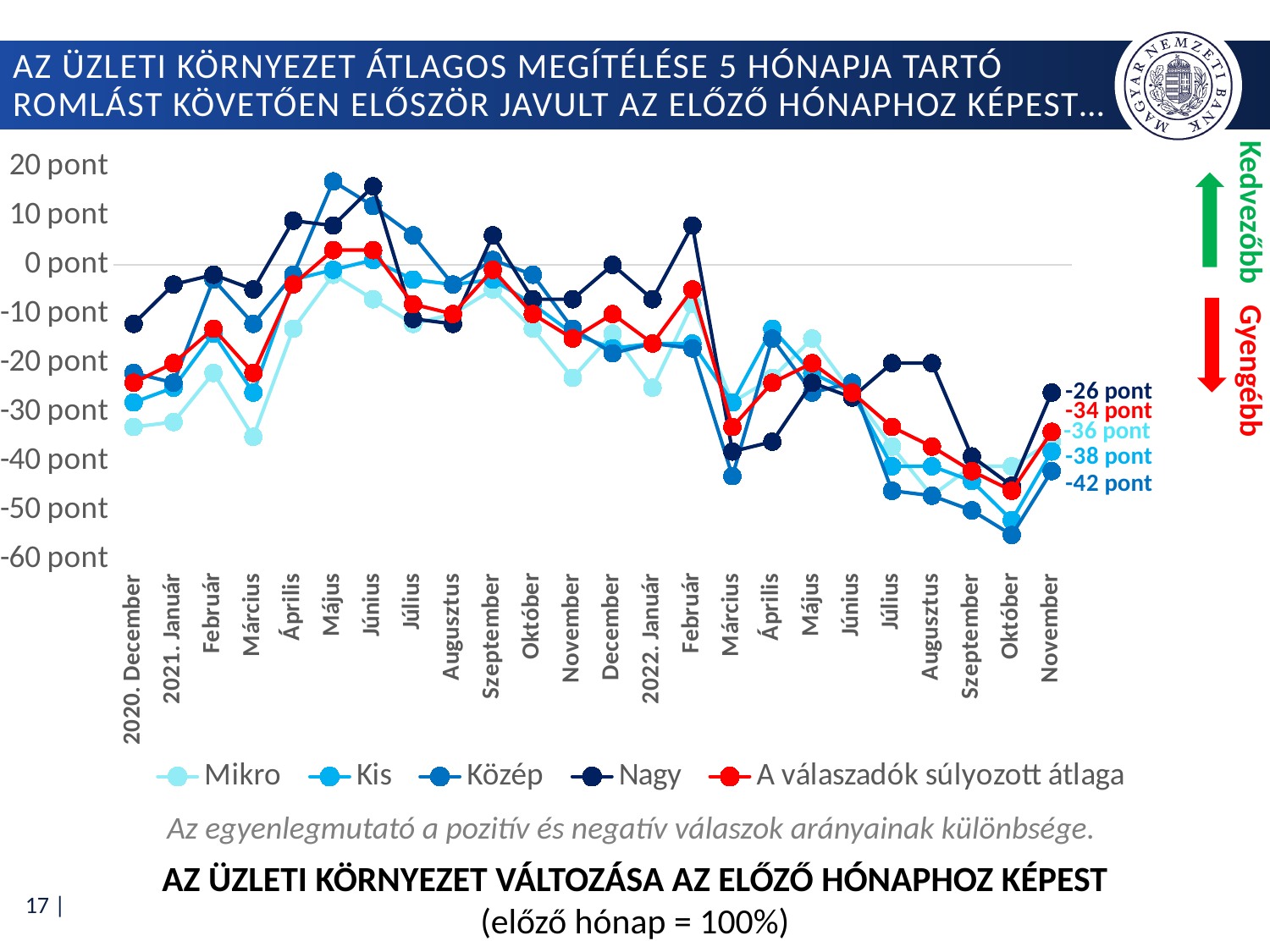
What is the value for Mikro in November 2022? -36 pont How many series does the legend list? 5 How many months are shown on the x axis? 24 What is the value for Kis in November 2022? -38 pont What is the value for Nagy in November 2022? -26 pont What is the value for A válaszadók súlyozott átlaga in November 2022? -34 pont What is the difference between the Nagy and Közép values in November 2022? 16 pont What kind of chart is shown on the slide? line chart Is the value for Közép in May 2021 greater or less than 10 pont? greater Which series has the lowest value in November 2022? Közép Which series has the highest value in November 2022? Nagy What is the value for Közép in November 2022? -42 pont